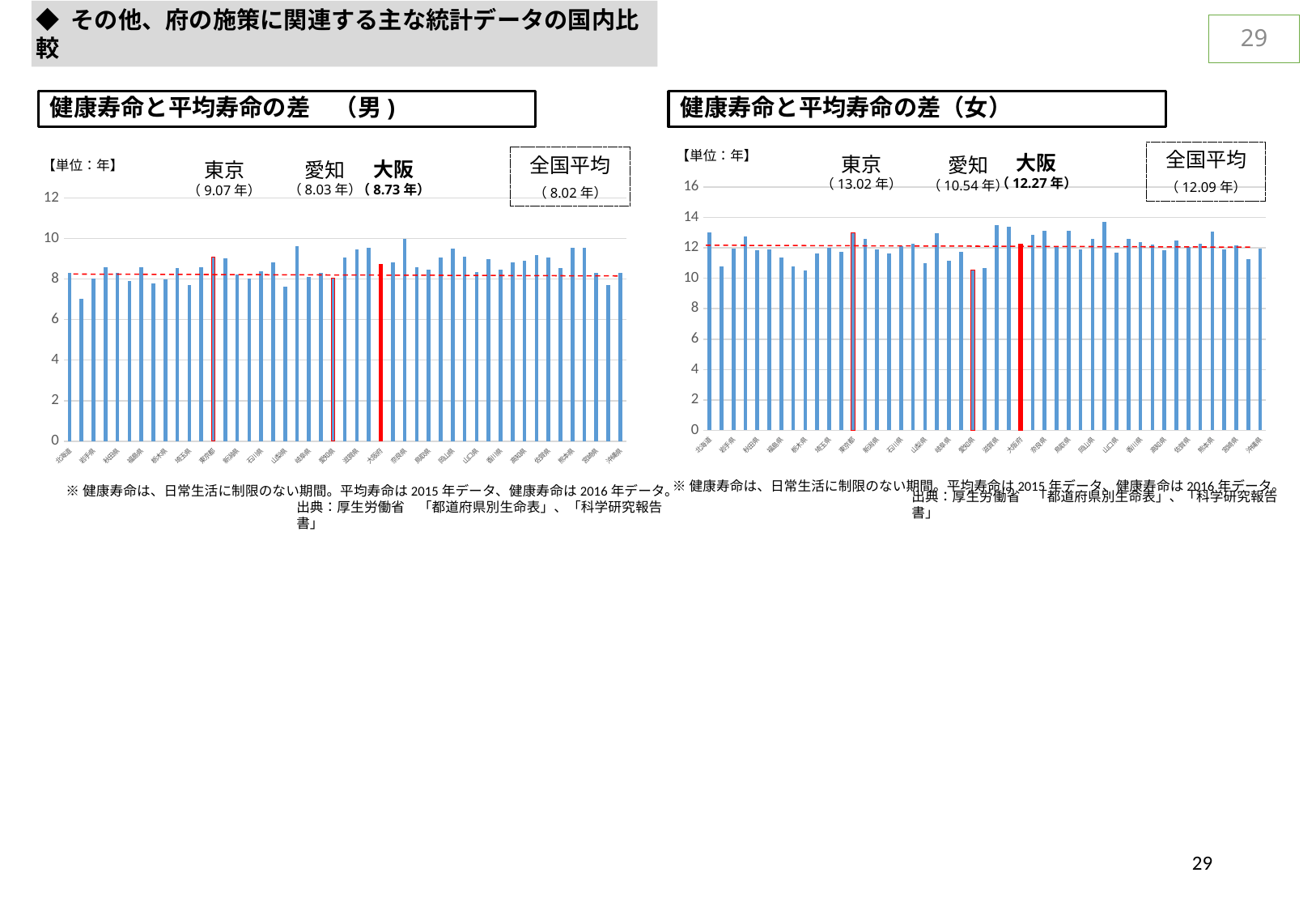
In the left chart (健康寿命と平均寿命の差（男）), what is the difference between the values for 東京 and 大阪? 0.34年 In the right chart (健康寿命と平均寿命の差（女）), what is the value for 愛知? 10.54年 In the left chart (健康寿命と平均寿命の差（男）), what is the 全国平均 value? 8.02年 In the left chart (健康寿命と平均寿命の差（男）), what is the value for 大阪? 8.73年 In the right chart (健康寿命と平均寿命の差（女）), what is the difference between the values for 大阪 and 愛知? 1.73年 In the right chart (健康寿命と平均寿命の差（女）), which is larger, the value for 大阪 or the value for 愛知? 大阪 In the right chart (健康寿命と平均寿命の差（女）), what is the value for 大阪? 12.27年 In the left chart (健康寿命と平均寿命の差（男）), what is the value for 愛知? 8.03年 In the right chart (健康寿命と平均寿命の差（女）), what is the value for 東京? 13.02年 In the left chart (健康寿命と平均寿命の差（男）), what is the value for 東京? 9.07年 In the right chart (健康寿命と平均寿命の差（女）), what is the 全国平均 value? 12.09年 What kind of chart is the left chart (健康寿命と平均寿命の差（男）)? bar chart